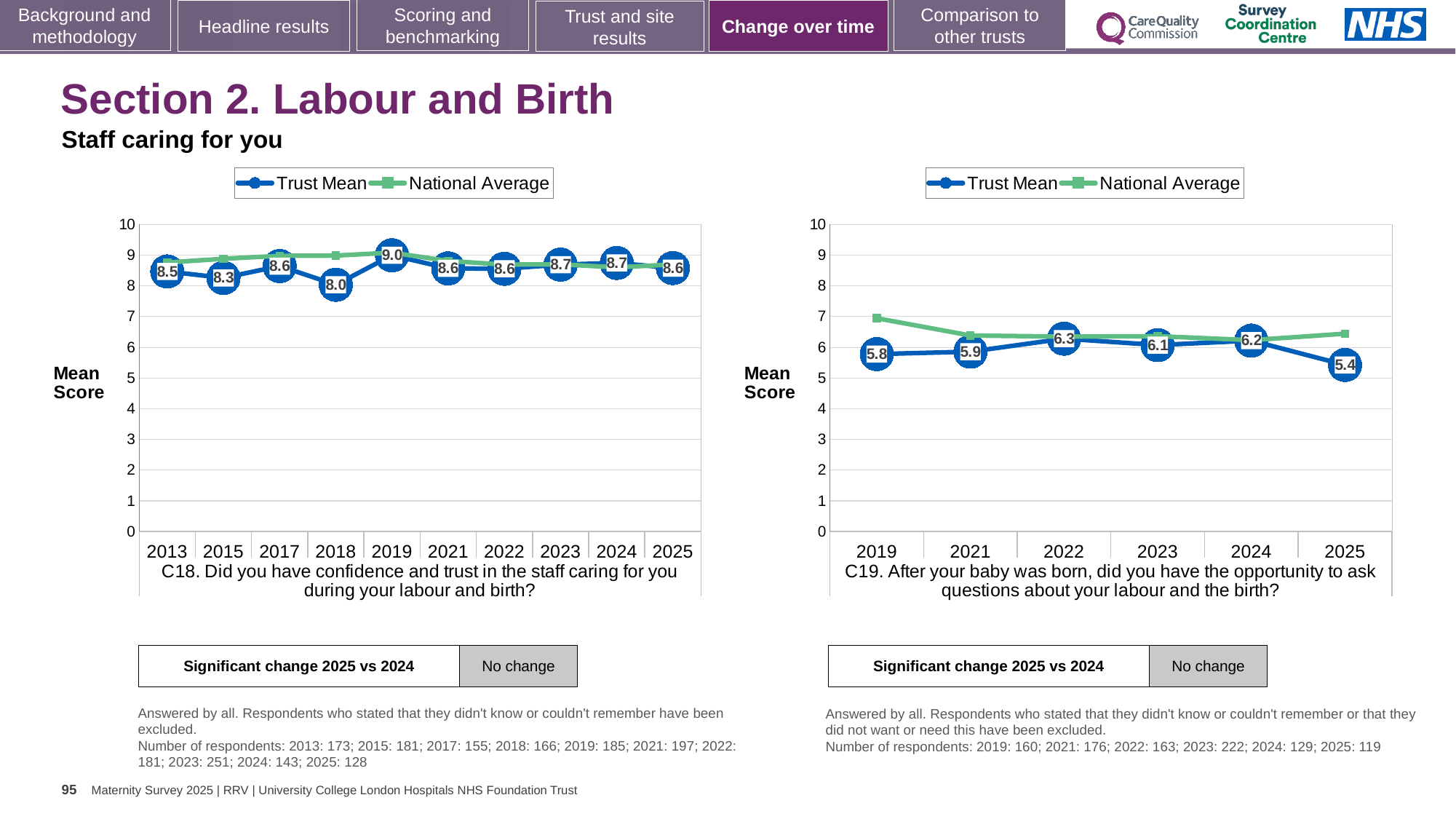
How many series does the legend of the C19 chart on the right list? 2 In the C19 chart on the right, is the National Average value for 2019 greater or less than 6? greater In the C18 chart on the left, what is the Trust Mean score for 2018? 8.0 In the C19 chart on the right, which year has the lowest Trust Mean score? 2025 In the C18 chart on the left, which year has the lowest Trust Mean score? 2018 In the C19 chart on the right, what is the Trust Mean score for 2025? 5.4 In the C18 chart on the left, what is the Trust Mean score for 2019? 9.0 In the C19 chart on the right, which year has the highest Trust Mean score? 2022 In the C18 chart on the left, which year has the highest Trust Mean score? 2019 In the C18 chart on the left, what is the difference between the Trust Mean scores for 2019 and 2018? 1.0 In the C19 chart on the right, is the Trust Mean for 2022 larger or smaller than the Trust Mean for 2019? larger How many years are plotted on the x axis of the C18 chart on the left? 10